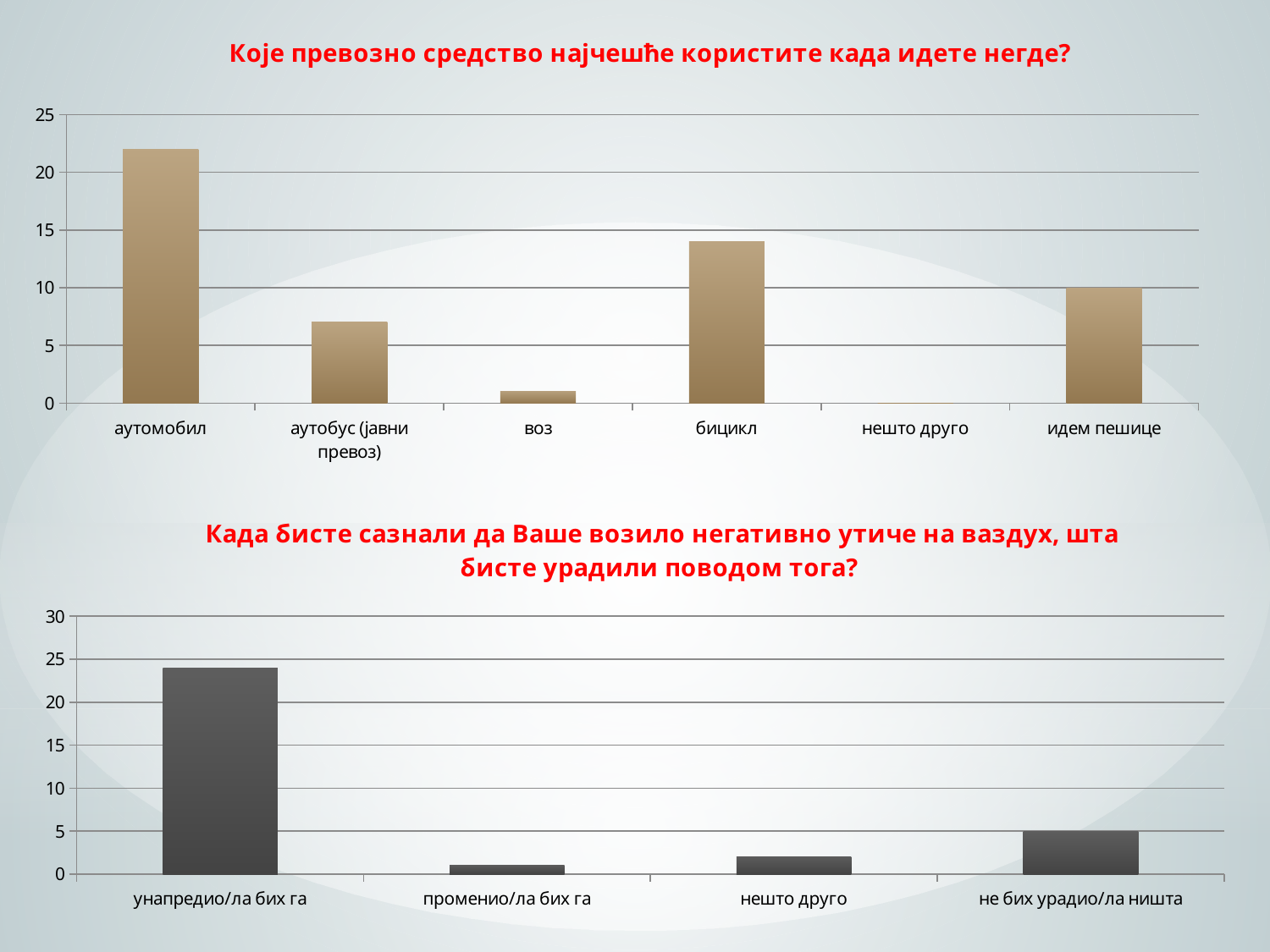
In the top chart, is the value for бицикл greater or less than 15? less How many categories are shown in the bottom chart? 4 In the top chart, which category has the highest value? аутомобил What type of chart is the top chart? bar chart What is the title of the top chart? Које превозно средство најчешће користите када идете негде? How many categories are shown in the top chart? 6 In the bottom chart, which category has the highest value? унапредио/ла бих га In the bottom chart, what is the value for не бих урадио/ла ништа? 5 In the top chart, is the value for аутомобил greater or less than 20? greater In the top chart, what is the value for идем пешице? 10 In the top chart, which is larger, аутобус (јавни превоз) or бицикл? бицикл In the bottom chart, is the value for унапредио/ла бих га greater or less than 20? greater